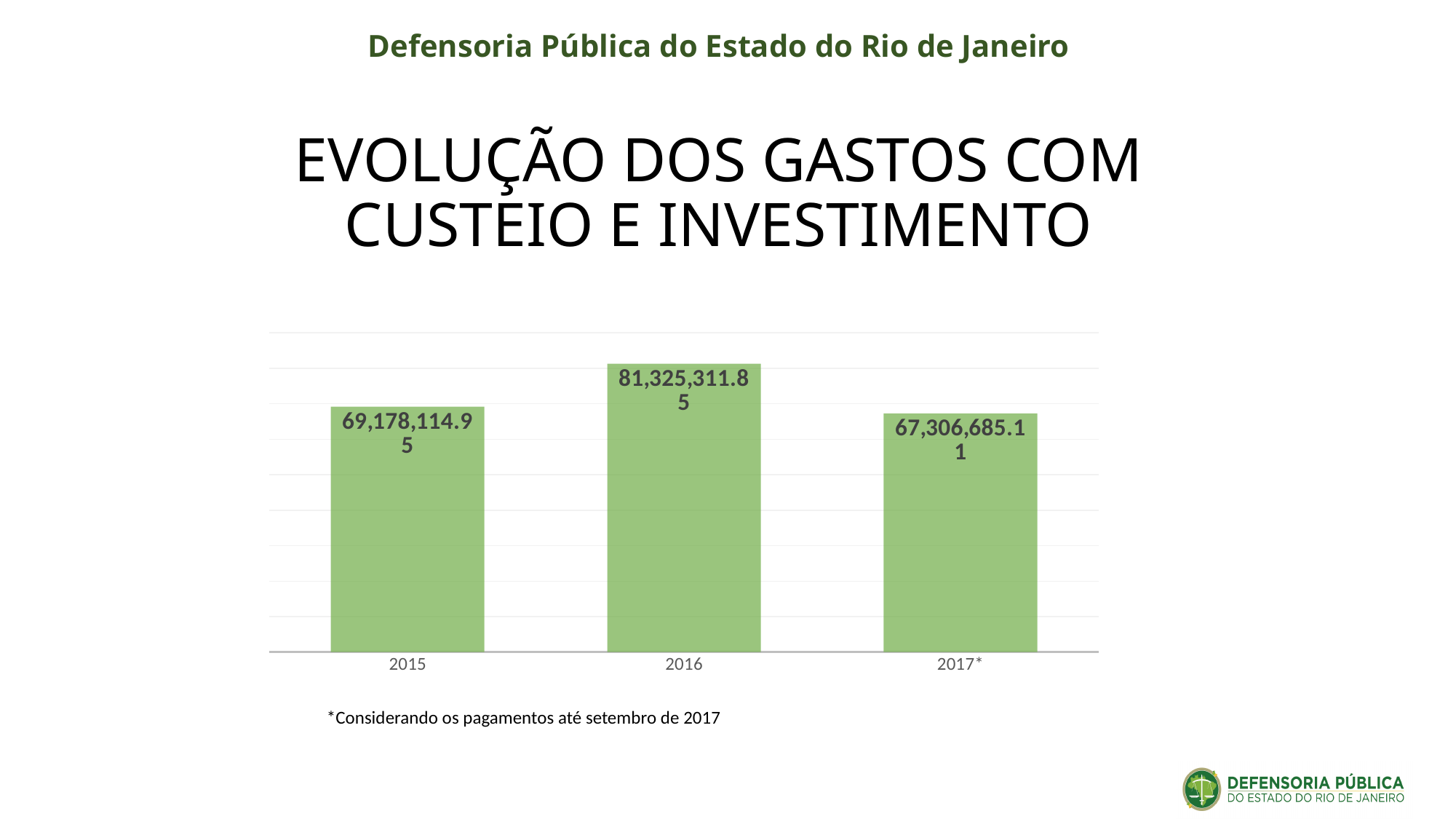
What is the value shown for 2016? 81,325,311.85 How many years are shown on the chart? 3 What is the value shown for 2015? 69,178,114.95 Does the value rise or fall from 2016 to 2017*? Fall Which year has the highest value? 2016 What kind of chart is shown on the slide? Bar chart What is the title of the chart on the slide? EVOLUÇÃO DOS GASTOS COM CUSTEIO E INVESTIMENTO Which is larger, the value for 2015 or the value for 2017*? 2015 Which year has the lowest value? 2017* What is the difference between the values for 2015 and 2017*? 1,871,429.84 What is the value shown for 2017*? 67,306,685.11 What is the difference between the values for 2016 and 2015? 12,147,196.90